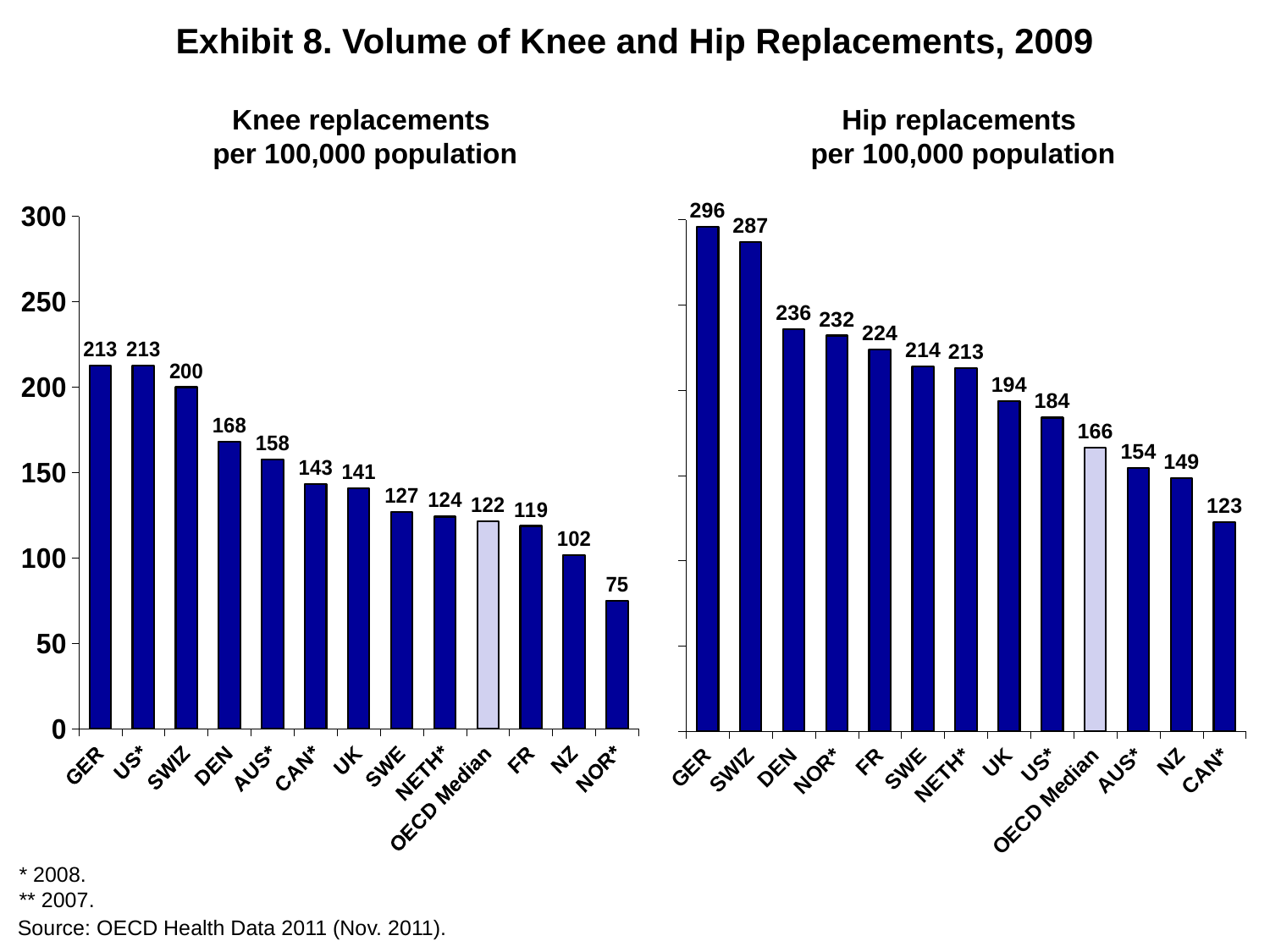
In the Knee replacements chart, is the value for CAN* greater or less than 150? less In the Hip replacements chart, what is the difference between GER and SWIZ? 9 How many categories are shown in the Knee replacements chart? 13 In the Hip replacements chart, do the values rise or fall from left to right along the x axis? fall What kind of chart is the Hip replacements chart? bar chart In the Hip replacements chart, which is larger, the value for UK or the value for US*? UK In the Hip replacements chart, which category has the highest value? GER In the Knee replacements chart, what is the difference between SWE and NZ? 25 In the Hip replacements chart, what is the value for the OECD Median? 166 In the Knee replacements chart, which bar is shown in a lighter colour than the others? OECD Median In the Knee replacements chart, what is the value for DEN? 168 In the Knee replacements chart, which category has the lowest value? NOR*